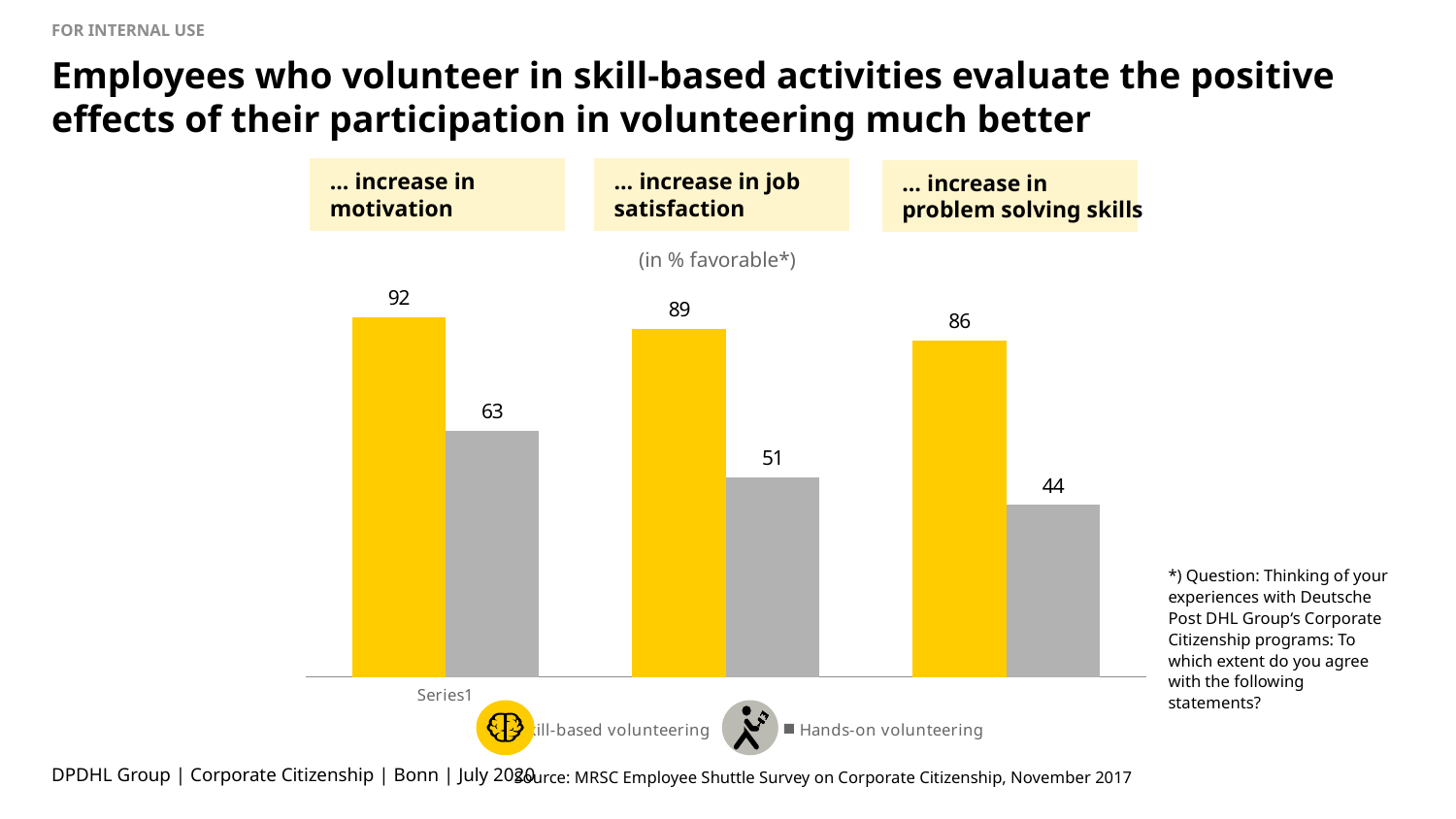
What is the difference between skill-based and hands-on volunteering for "increase in motivation"? 29 What is the value for hands-on volunteering for "increase in job satisfaction"? 51 What is the value for skill-based volunteering for "increase in problem solving skills"? 86 What is the difference between skill-based and hands-on volunteering for "increase in problem solving skills"? 42 How many categories are shown in the chart? 3 Which category has the lowest value for hands-on volunteering? increase in problem solving skills Which is larger for "increase in job satisfaction": skill-based volunteering or hands-on volunteering? Skill-based volunteering Which category has the highest value for skill-based volunteering? increase in motivation What kind of chart is shown on the slide? Bar chart How many series does the legend list? 2 What is the value for hands-on volunteering for "increase in problem solving skills"? 44 What is the value for skill-based volunteering for "increase in motivation"? 92